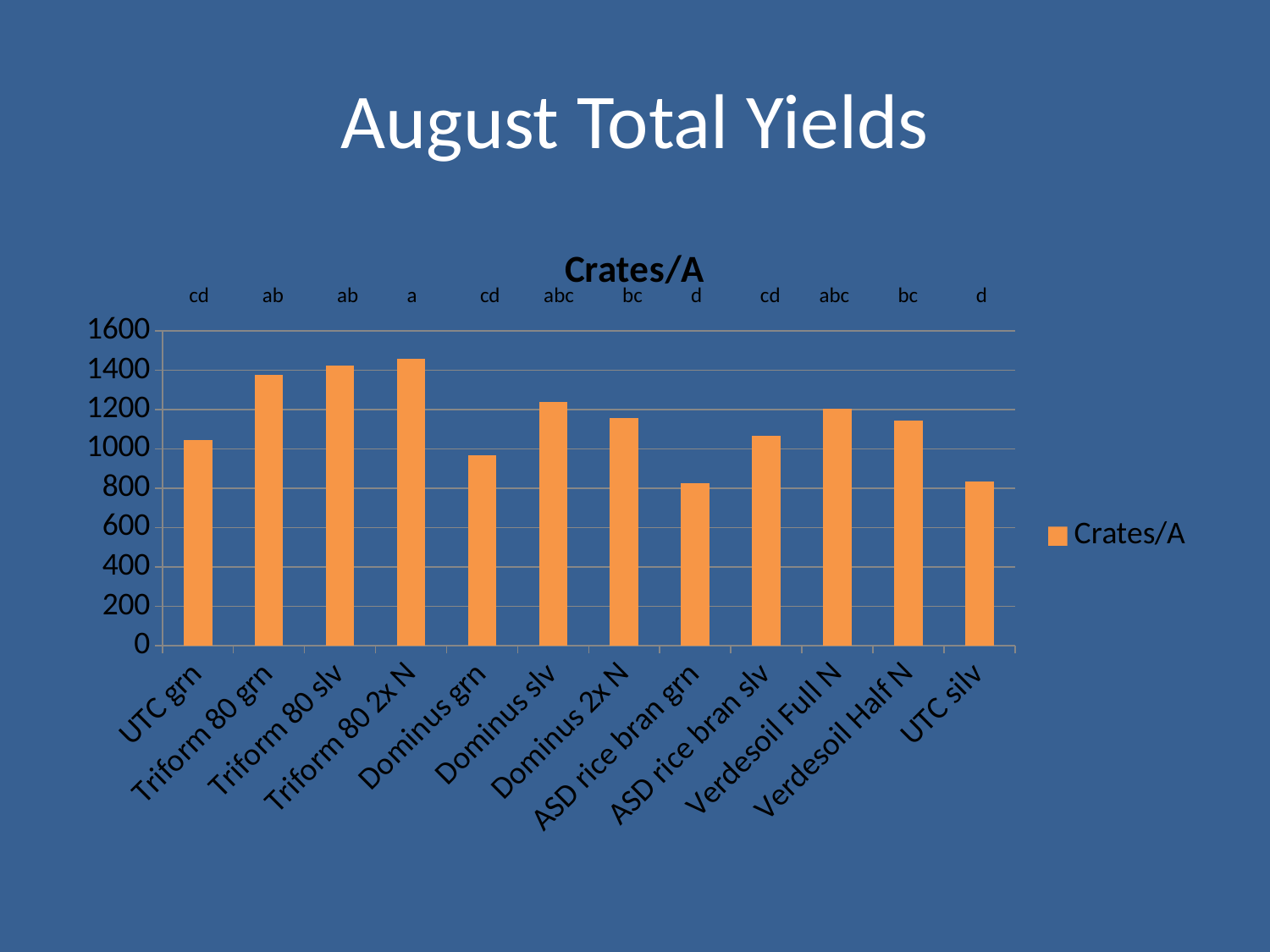
Is the value for Verdesoil Full N greater or less than 1000? greater Is the value for Triform 80 grn greater or less than 1200? greater Which category has the highest value in the chart? Triform 80 2x N Is the value for UTC grn greater or less than 1000? greater What kind of chart is shown on the slide? bar chart Which is larger, the value for Verdesoil Full N or the value for UTC silv? Verdesoil Full N Which is larger, the value for Triform 80 slv or the value for Dominus grn? Triform 80 slv How many categories are plotted on the x axis of the chart? 12 What is the title shown above the chart's plot area? Crates/A How many series does the chart's legend list? 1